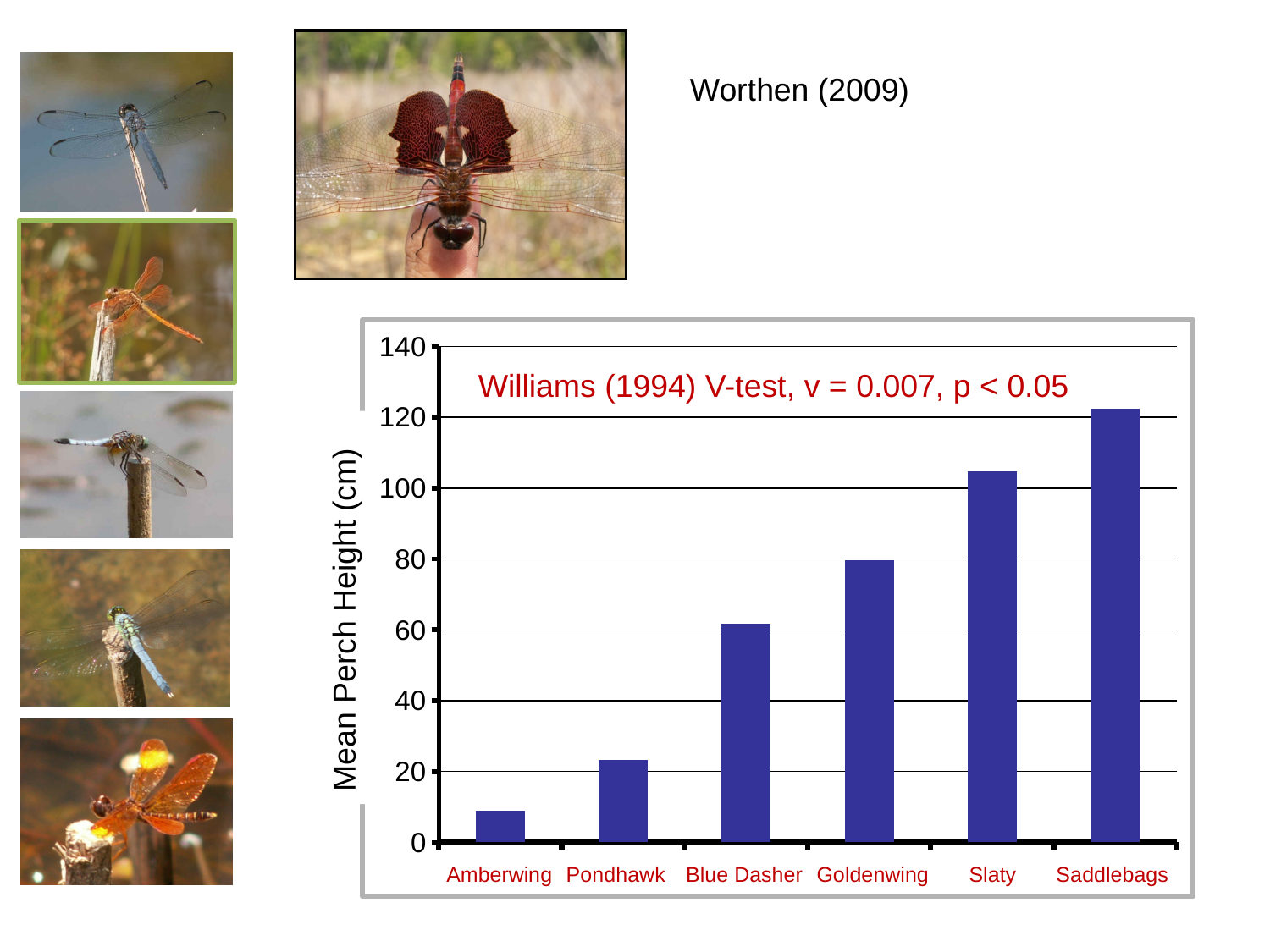
Is the mean perch height for Amberwing greater or less than 20? less What kind of chart is shown on the slide? bar chart Is the mean perch height for Goldenwing greater or less than 60? greater What is the label on the y axis of the chart? Mean Perch Height (cm) How many dragonfly species are shown on the x axis of the chart? 6 Which species has the lowest mean perch height? Amberwing Which species has the highest mean perch height? Saddlebags Is the mean perch height for Blue Dasher greater or less than 40? greater Do the mean perch heights rise or fall from Amberwing to Saddlebags along the x axis? rise Which has a larger mean perch height, Slaty or Blue Dasher? Slaty